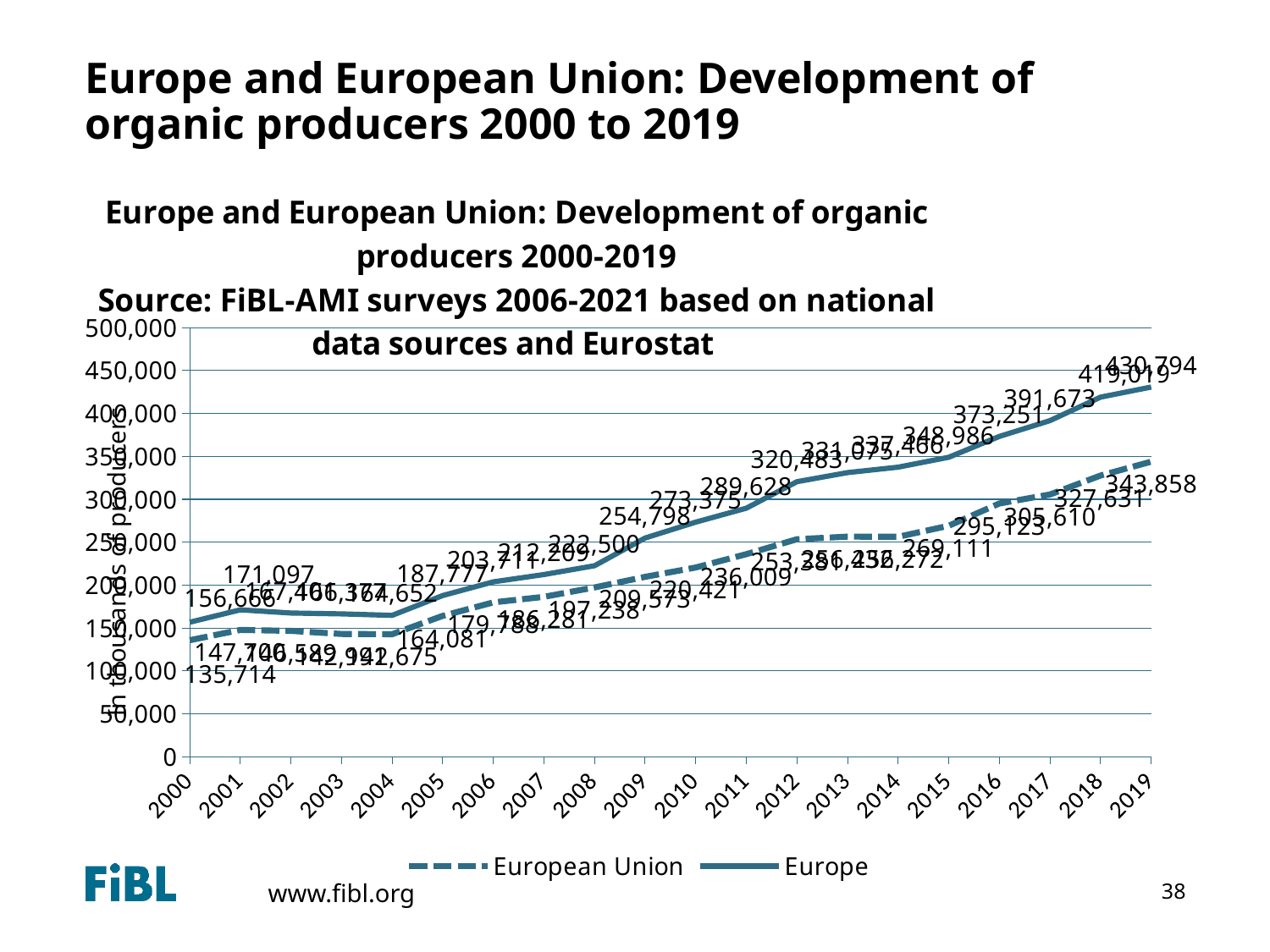
What is the value for Europe in 2017? 391,673 In which year is the Europe series highest? 2019 What is the value for Europe in 2019? 430,794 What is the value for the European Union in 2000? 135,714 What is the value for Europe in 2000? 156,666 What type of chart is shown on the slide? Line chart How many series does the legend list? 2 How many years are shown on the x axis? 20 Which series has the larger value in 2016, Europe or European Union? Europe What is the value for the European Union in 2019? 343,858 In which year is the European Union series lowest? 2000 What is the difference between the Europe and European Union values in 2019? 86,936